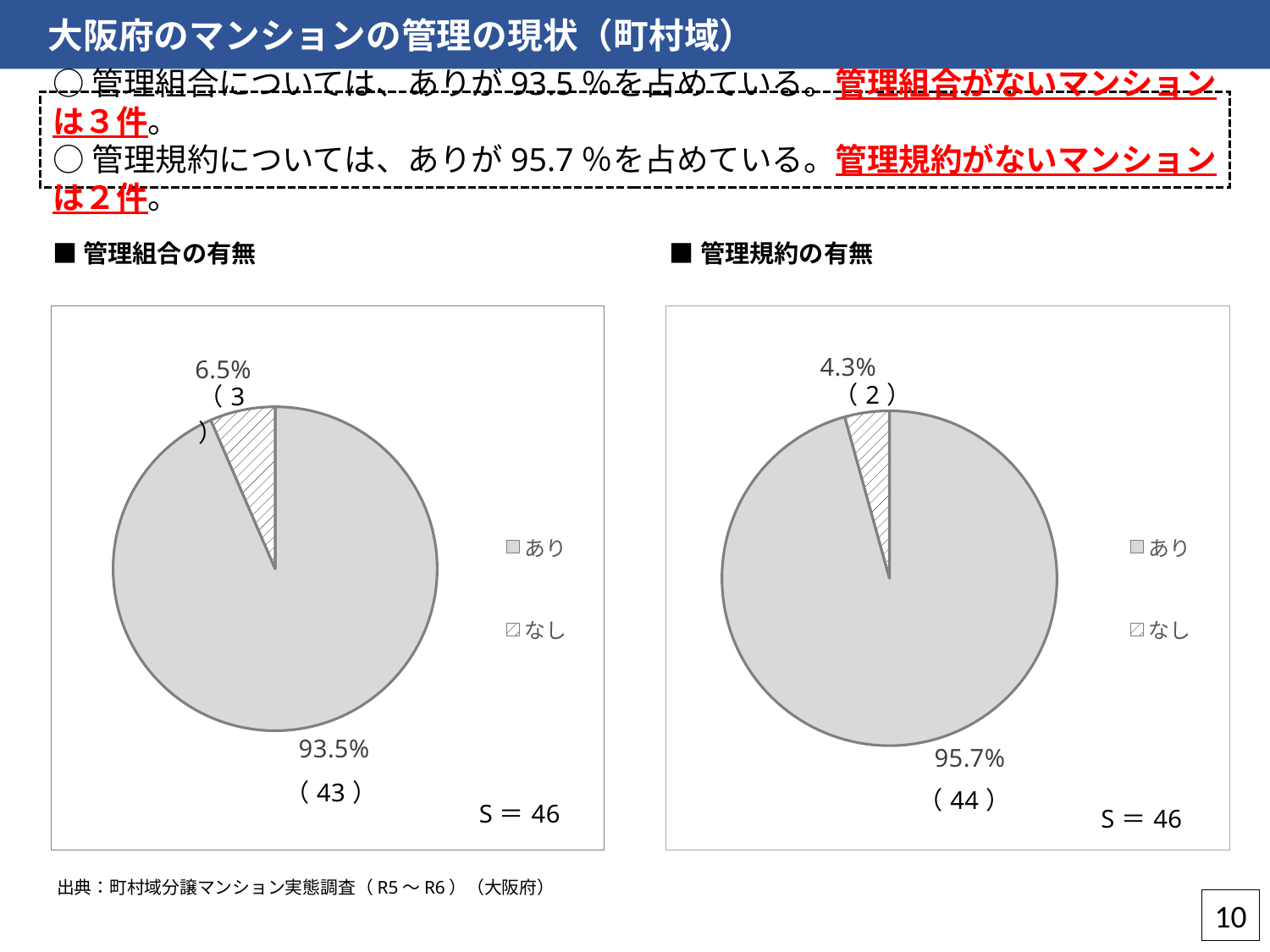
In the 管理組合の有無 chart, what is the difference in percentage points between あり and なし? 87 percentage points In the 管理組合の有無 chart, what percentage is shown for あり? 93.5% How many entries does the legend of the 管理規約の有無 chart list? 2 In the 管理組合の有無 chart, what percentage is shown for なし? 6.5% What is the sample size (S) shown on the 管理規約の有無 chart? 46 In the 管理組合の有無 chart, which slice is the largest? あり In the 管理規約の有無 chart, which slice is the smallest? なし What kind of chart is the 管理組合の有無 chart? Pie chart In the 管理規約の有無 chart, how many cases are shown in parentheses for なし? 2 In the 管理規約の有無 chart, what percentage is shown for あり? 95.7% In the 管理規約の有無 chart, how many cases are shown in parentheses for あり? 44 In the 管理組合の有無 chart, how many cases are shown in parentheses for なし? 3